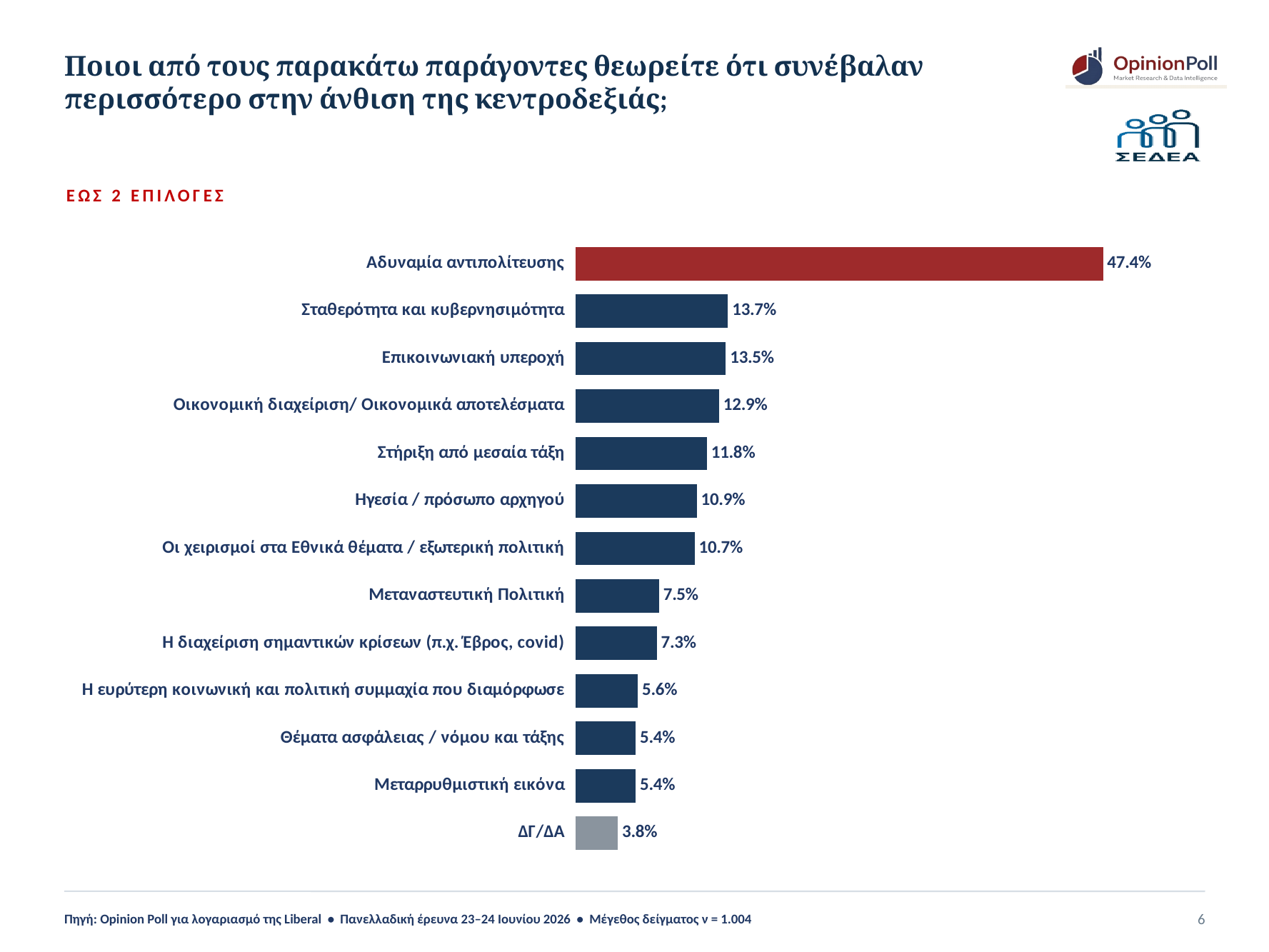
How many categories are shown in the chart? 13 What kind of chart is shown on the slide? Bar chart What value is shown for ΔΓ/ΔΑ? 3.8% Which category has the highest value in the chart? Αδυναμία αντιπολίτευσης What percentage is shown for Αδυναμία αντιπολίτευσης? 47.4% What value is shown for Στήριξη από μεσαία τάξη? 11.8% Which category has the lowest value in the chart? ΔΓ/ΔΑ Which is larger: the value for Ηγεσία / πρόσωπο αρχηγού or the value for Η διαχείριση σημαντικών κρίσεων (π.χ. Έβρος, covid)? Ηγεσία / πρόσωπο αρχηγού What percentage is shown for Μεταναστευτική Πολιτική? 7.5% Which bar in the chart is coloured red? Αδυναμία αντιπολίτευσης Which is larger: the value for Επικοινωνιακή υπεροχή or the value for Οικονομική διαχείριση/ Οικονομικά αποτελέσματα? Επικοινωνιακή υπεροχή What is the difference in percentage points between Αδυναμία αντιπολίτευσης and Σταθερότητα και κυβερνησιμότητα? 33.7 percentage points